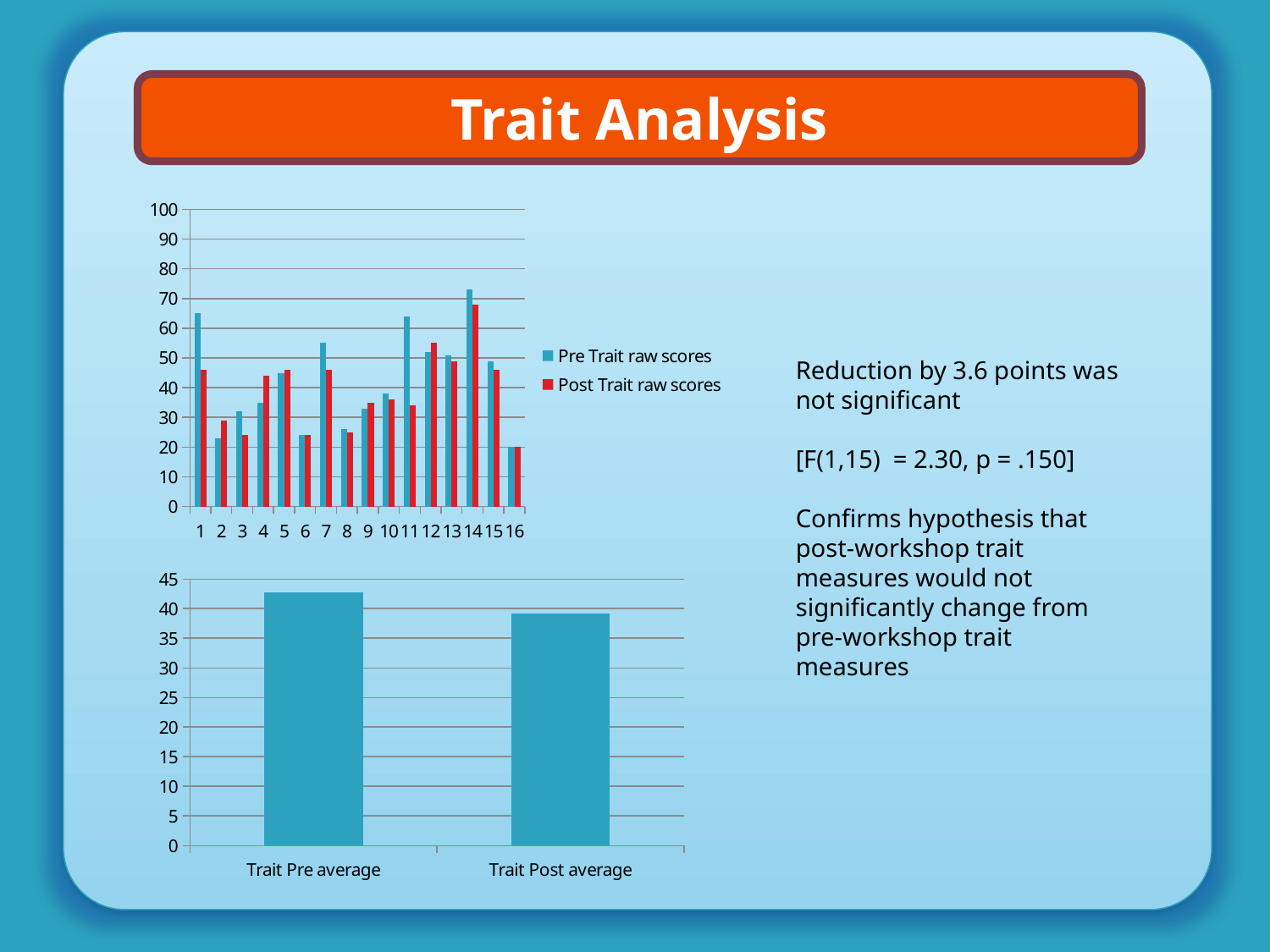
What kind of chart is the bottom chart on the slide? bar chart What kind of chart is the top chart on the slide? bar chart How many categories are shown on the x axis of the top chart? 16 In the top chart, which category has the highest Pre Trait raw score? 14 In the bottom chart, which is larger: Trait Pre average or Trait Post average? Trait Pre average In the top chart, is the Pre Trait raw score for category 1 greater or less than 60? greater In the top chart, which series is shown in red? Post Trait raw scores In the top chart, is the Post Trait raw score for category 16 greater or less than 30? less In the bottom chart, is the value for Trait Pre average greater or less than 40? greater In the top chart, for category 11, which is larger: the Pre Trait raw score or the Post Trait raw score? Pre Trait raw scores How many bars are in the bottom chart? 2 How many series does the legend of the top chart list? 2